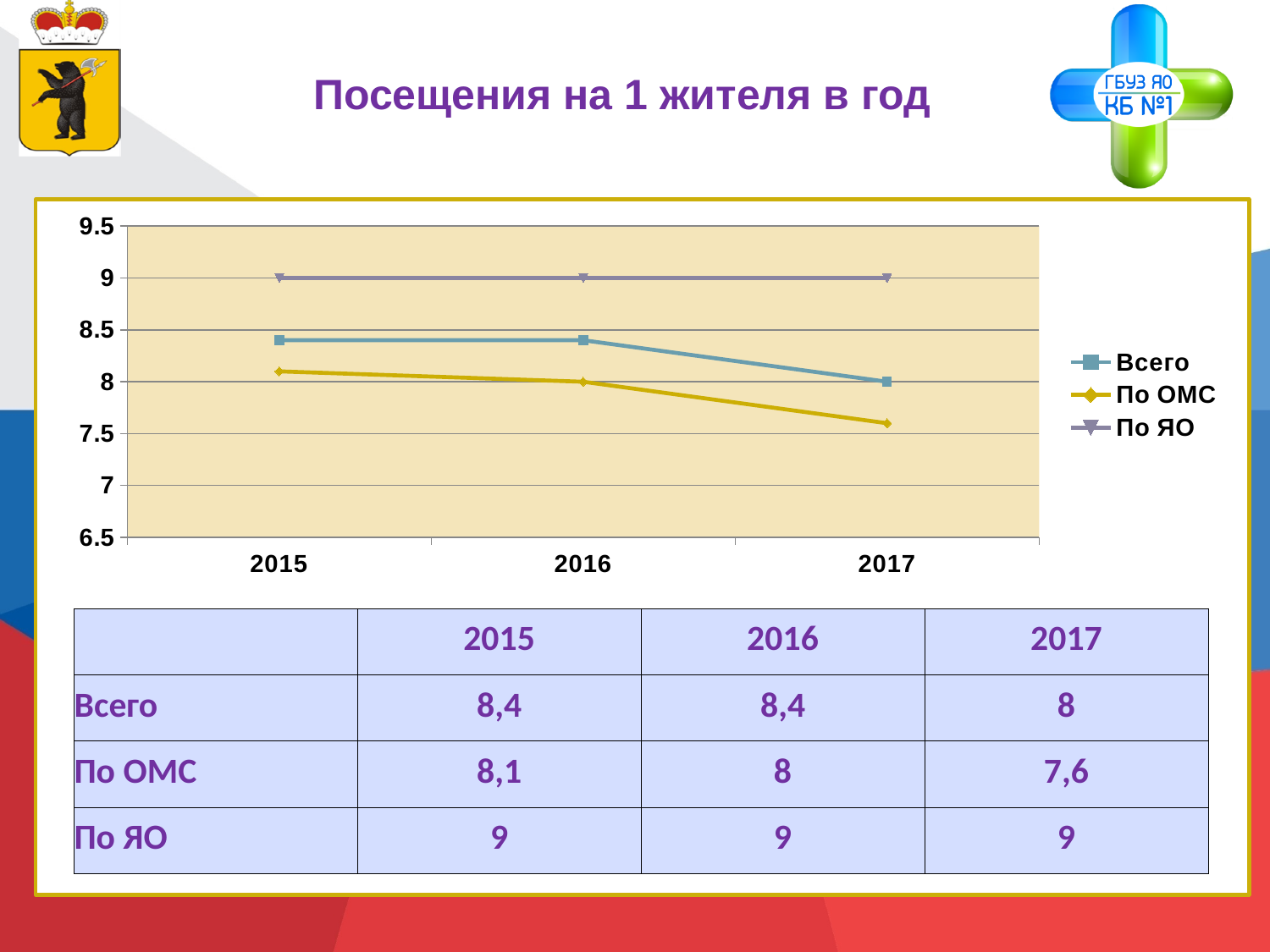
What is the difference between По ЯО and По ОМС in 2017? 1,4 Which is larger in 2015: Всего or По ОМС? Всего How many years are plotted along the x axis of the chart? 3 What is the value for По ЯО in 2016? 9 Which series has the lowest value in 2016? По ОМС What is the title of the chart on the slide? Посещения на 1 жителя в год Which series has the highest value in 2017? По ЯО What is the value for Всего in 2017? 8 Does the По ОМС series rise or fall from 2015 to 2017? fall What is the value for По ОМС in 2015? 8,1 How many series does the chart legend list? 3 What kind of chart is shown on the slide? line chart